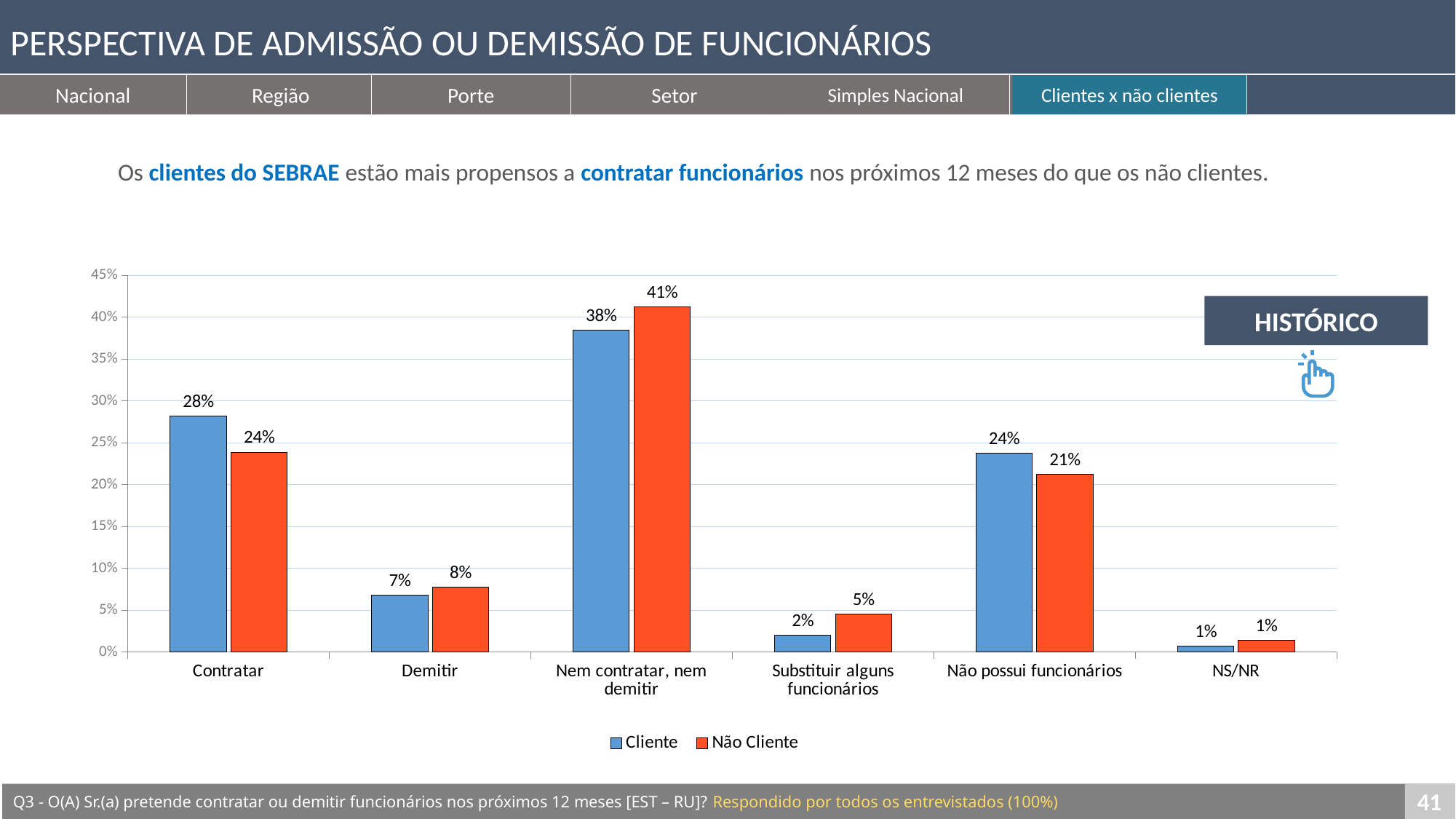
How many series does the legend list? 2 What is the value for Não Cliente in the Nem contratar, nem demitir category? 41% What is the difference between Cliente and Não Cliente in the Contratar category? 4% Which colour represents the Não Cliente series? Orange Is the value for Não Cliente in the Nem contratar, nem demitir category greater or less than 40%? greater How many categories are shown on the x axis? 6 What kind of chart is shown on the slide? Bar chart What is the value for Cliente in the Contratar category? 28% In the Não possui funcionários category, which is larger: Cliente or Não Cliente? Cliente Which category has the highest value for the Cliente series? Nem contratar, nem demitir Which category has the lowest value for the Não Cliente series? NS/NR What is the value for Não Cliente in the Substituir alguns funcionários category? 5%